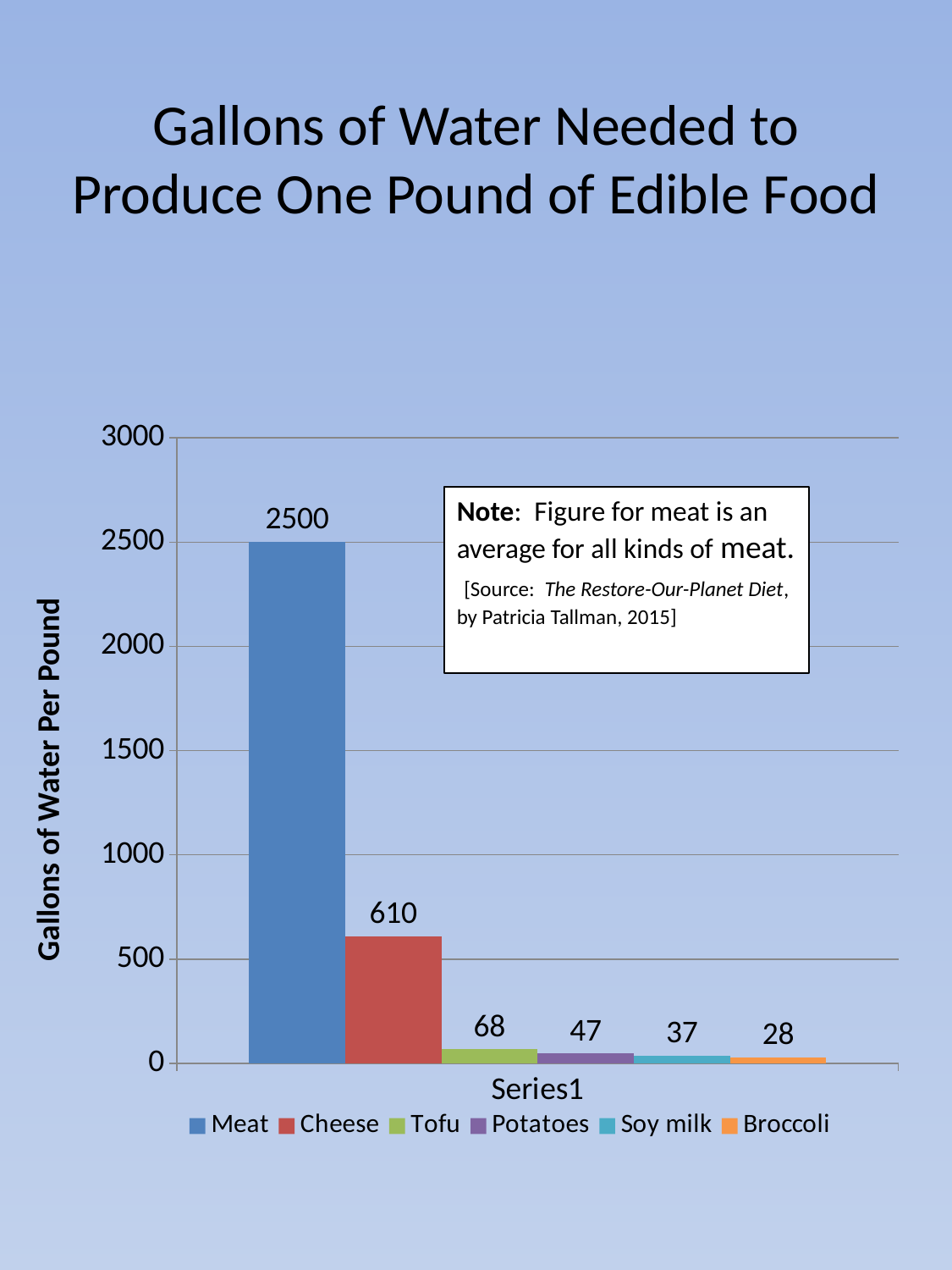
Which food requires the most gallons of water per pound? Meat Which requires more water per pound, Tofu or Potatoes? Tofu What is the value shown for Broccoli? 28 What kind of chart is shown on the slide? Bar chart What is the label on the vertical axis? Gallons of Water Per Pound How many gallons of water are needed to produce one pound of meat? 2500 How many foods are listed in the legend? 6 What is the value shown for Cheese? 610 What is the difference between the values for Potatoes and Soy milk? 10 What is the value shown for Tofu? 68 What is the difference between the values for Meat and Cheese? 1890 Which food requires the fewest gallons of water per pound? Broccoli